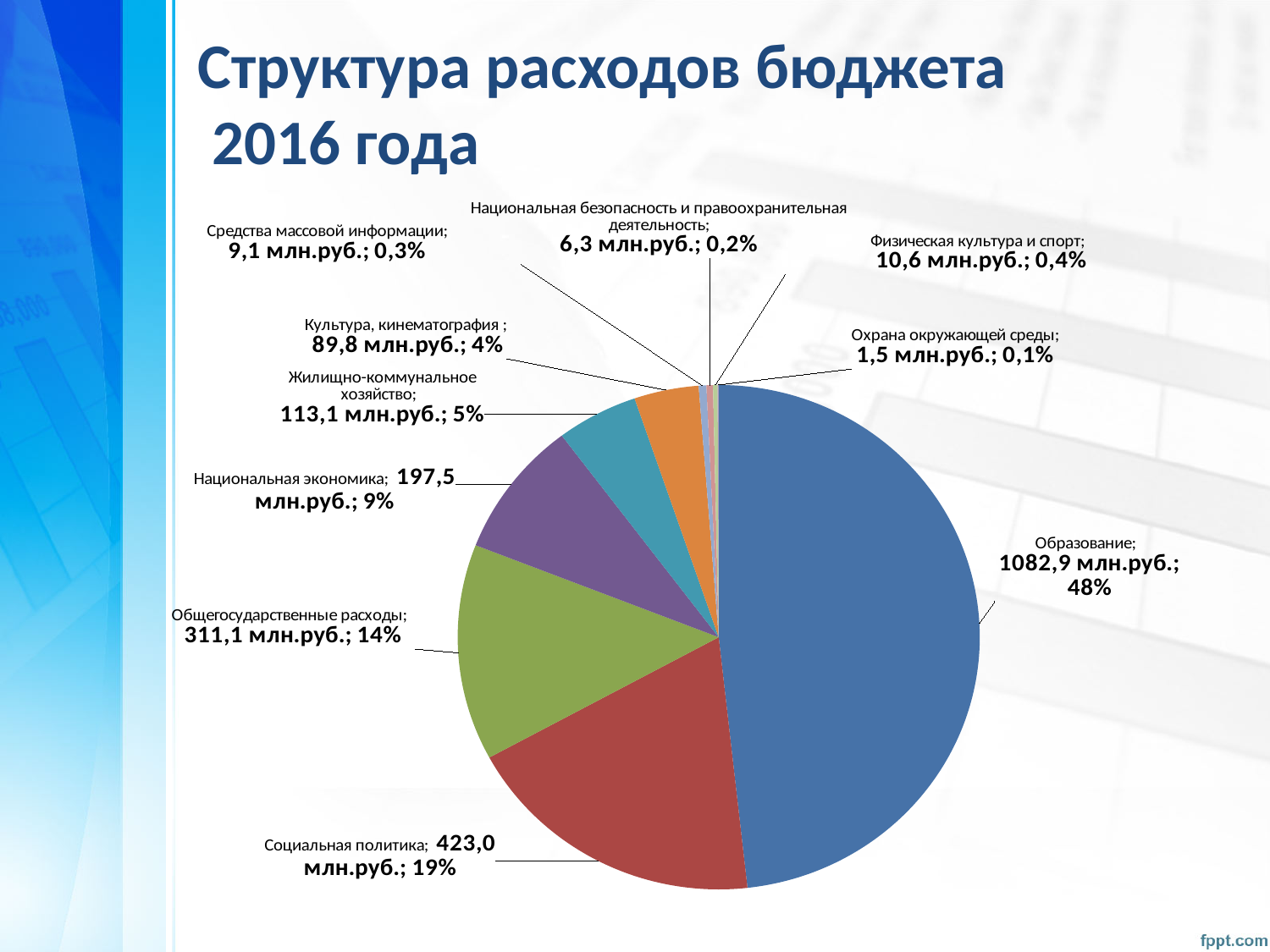
What is the value for Физическая культура и спорт? 10,6 млн.руб. What is the value for Образование? 1082,9 млн.руб. How many categories (slices) does the pie chart have? 10 What is the value for Общегосударственные расходы? 311,1 млн.руб. What share of the pie does Национальная экономика represent? 9% What type of chart is shown on the slide? pie chart Which is larger: Жилищно-коммунальное хозяйство or Культура, кинематография? Жилищно-коммунальное хозяйство Which category has the smallest slice of the pie? Охрана окружающей среды Which category has the largest slice of the pie? Образование What is the difference between the values for Социальная политика and Общегосударственные расходы? 111,9 млн.руб. What share of the pie does Социальная политика represent? 19% What is the title of the chart on the slide? Структура расходов бюджета 2016 года